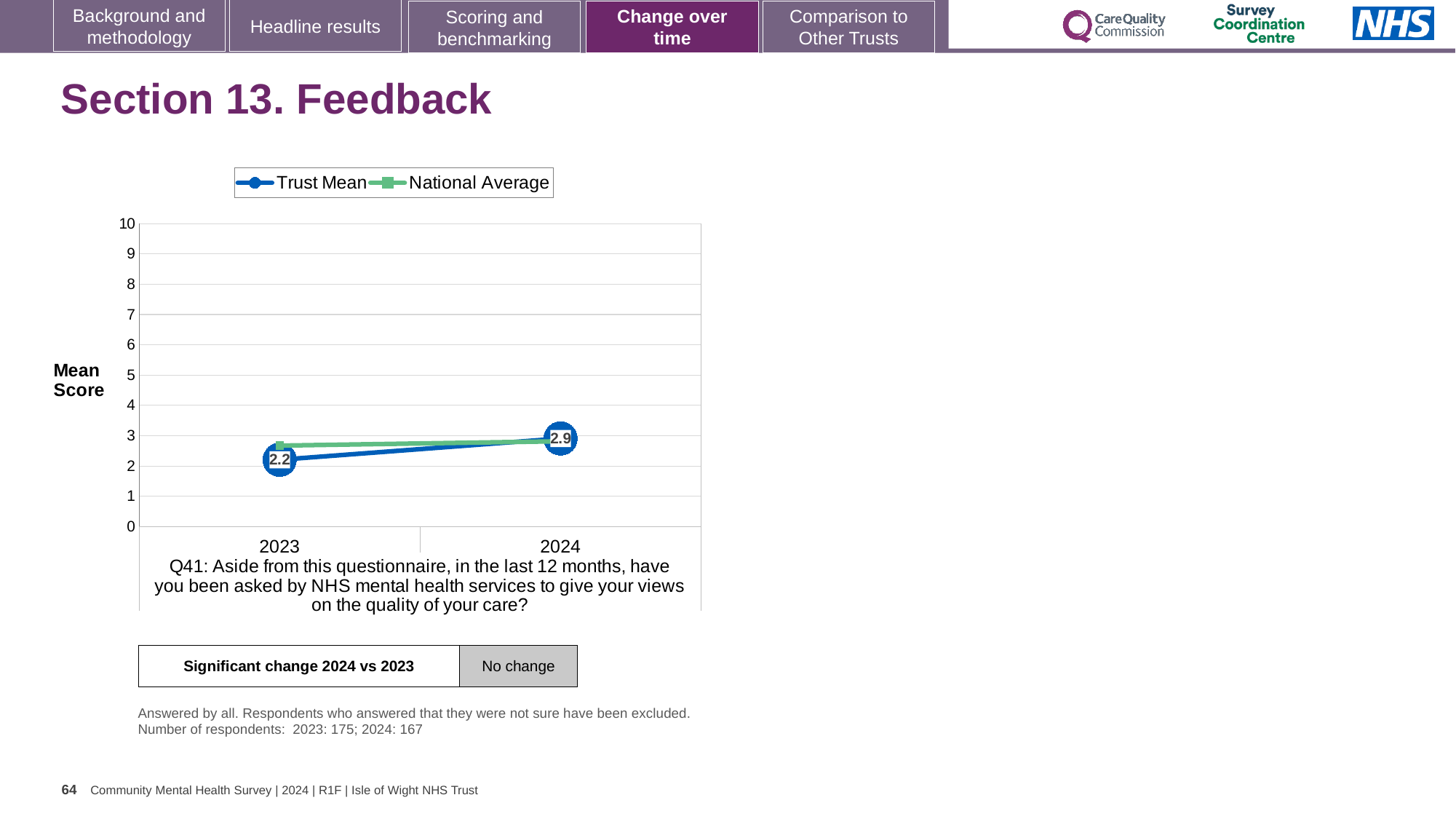
What is the Trust Mean value for 2023? 2.2 How many series does the legend list? 2 Does the Trust Mean rise or fall from 2023 to 2024? rise How many years are plotted on the x axis? 2 What is the label on the y axis of the chart? Mean Score By how much did the Trust Mean change from 2023 to 2024? 0.7 Is the National Average value for 2023 greater or less than 5? less What is the Trust Mean value for 2024? 2.9 Which year has the lowest Trust Mean? 2023 In 2023, which is higher, the Trust Mean or the National Average? National Average Which year has the higher Trust Mean, 2023 or 2024? 2024 What kind of chart is shown on the slide? line chart